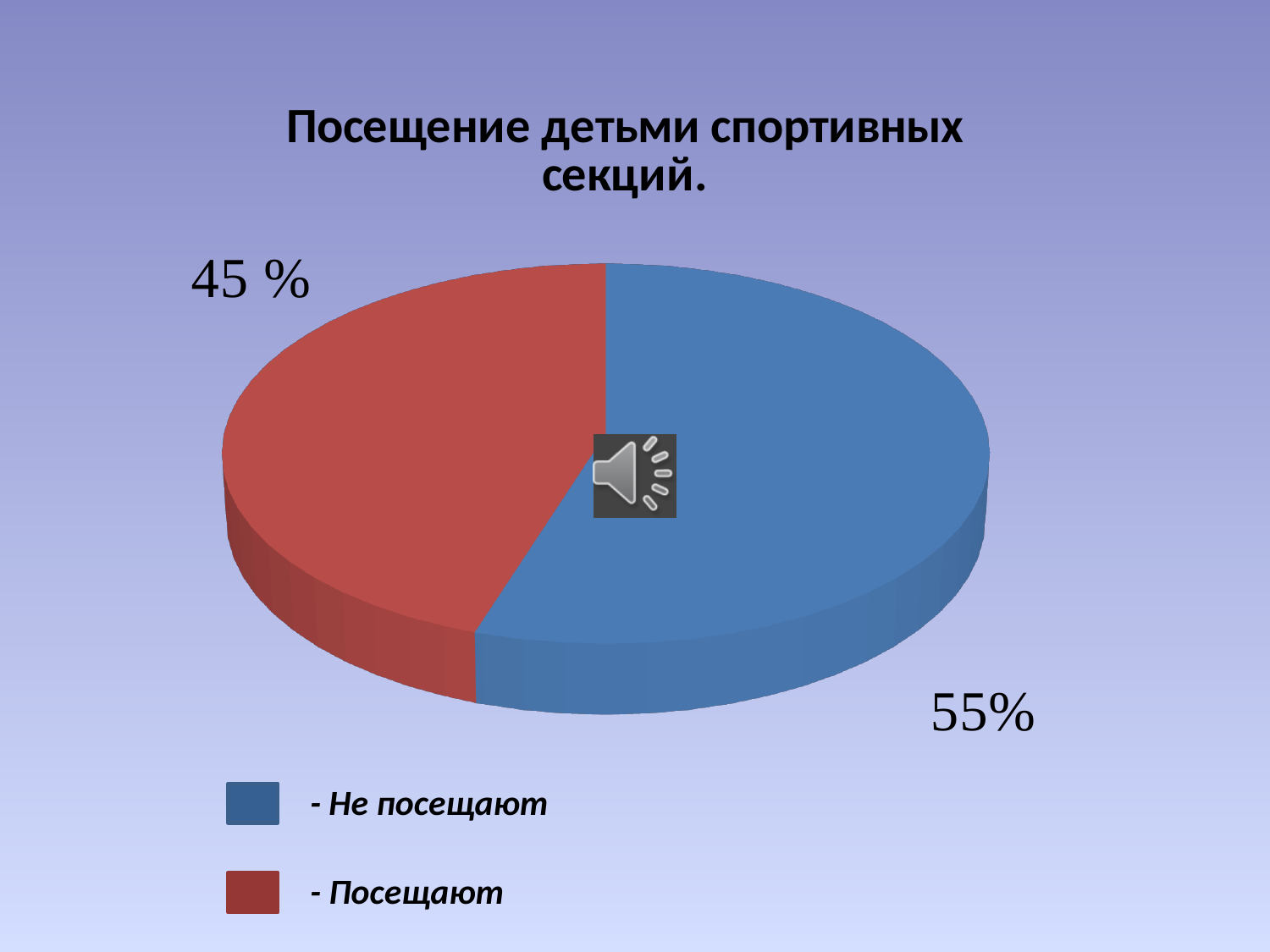
By how many percentage points does the "Не посещают" slice exceed the "Посещают" slice? 10 What share of the pie is labelled for "Посещают"? 45 % Which is larger, the slice for "Посещают" or the slice for "Не посещают"? Не посещают Which colour represents "Посещают" in the chart? red How many slices does the pie chart have? 2 What is the title of the chart? Посещение детьми спортивных секций. How many entries does the legend list? 2 What share of the pie is labelled for "Не посещают"? 55% Which category has the smallest slice of the pie? Посещают Which category has the largest slice of the pie? Не посещают What kind of chart is shown on the slide? pie chart Is the share for "Посещают" greater or less than 50%? less